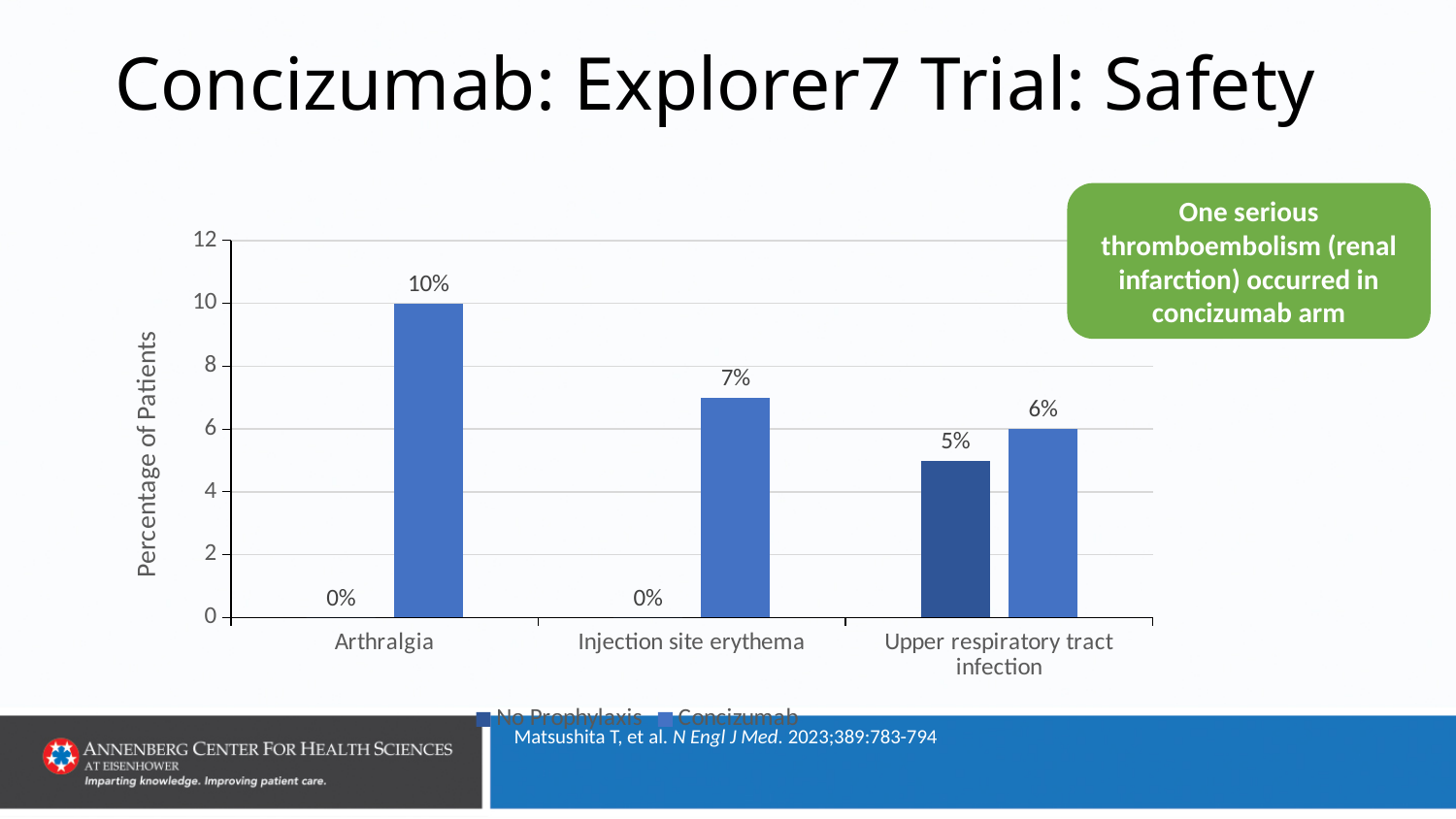
Which category has the lowest Concizumab value? Upper respiratory tract infection How many categories are shown on the x axis? 3 Which is larger for Injection site erythema: the Concizumab value or the No Prophylaxis value? Concizumab What kind of chart is shown on the slide? Bar chart What is the difference between the Concizumab and No Prophylaxis values for Upper respiratory tract infection? 1% What is the value for Concizumab in the Injection site erythema category? 7% What is the label of the y axis? Percentage of Patients What is the value for No Prophylaxis in the Upper respiratory tract infection category? 5% Which category has the highest Concizumab value? Arthralgia How many series does the legend list? 2 What is the value for No Prophylaxis in the Arthralgia category? 0% What is the value for Concizumab in the Arthralgia category? 10%